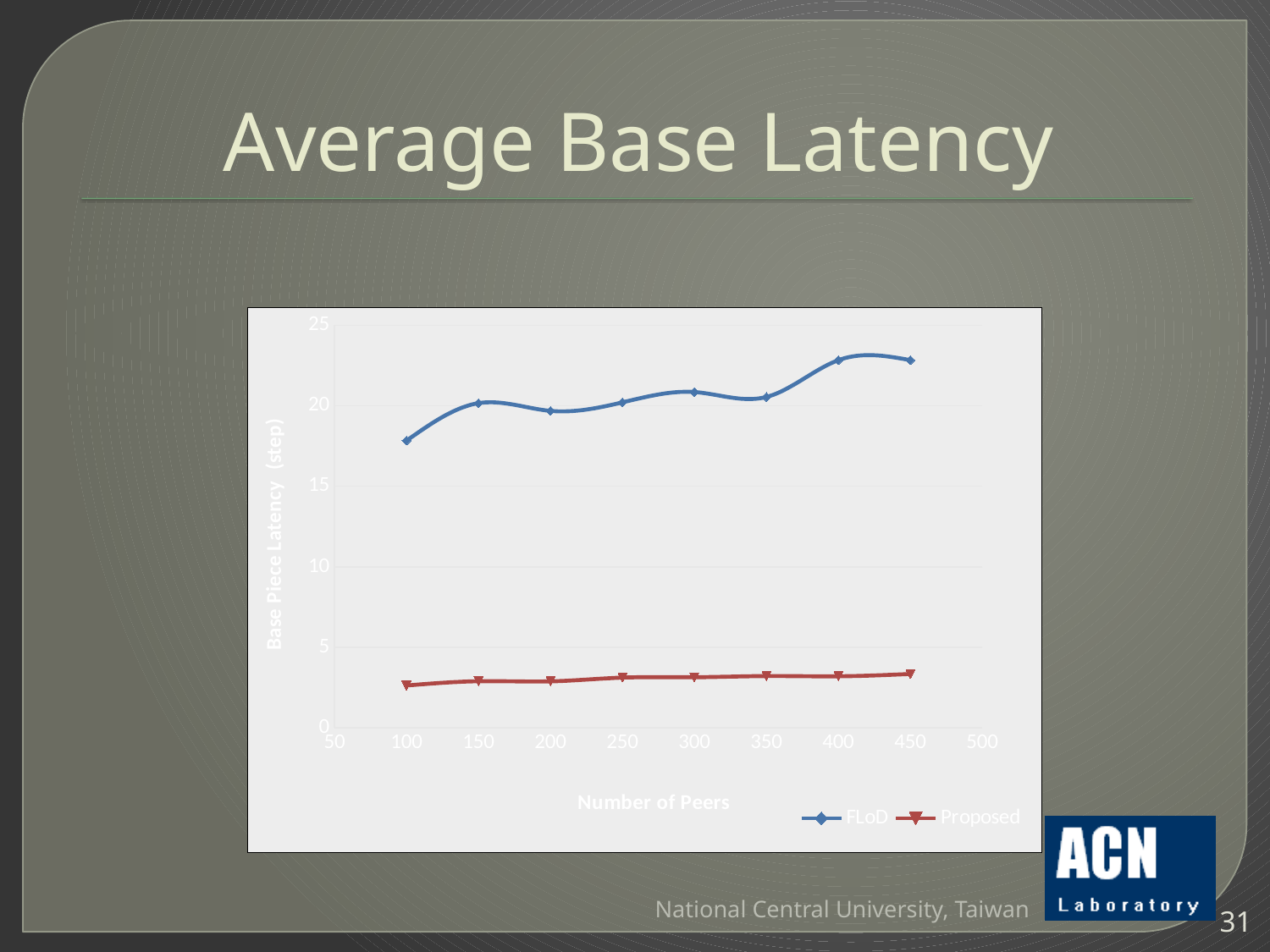
Is the Proposed value at 100 peers greater or less than 5? less How many series does the legend list? 2 Does the FLoD series generally rise or fall as the number of peers increases? rise What kind of chart is shown on the slide? line chart Is the Proposed value at 450 peers greater or less than 5? less How many data points are plotted for the FLoD series? 8 Is the FLoD value at 100 peers greater or less than 20? less At which number of peers is the FLoD series lowest? 100 What is the title of the y axis? Base Piece Latency (step) What is the title of the x axis? Number of Peers At 250 peers, which series has the higher base piece latency, FLoD or Proposed? FLoD